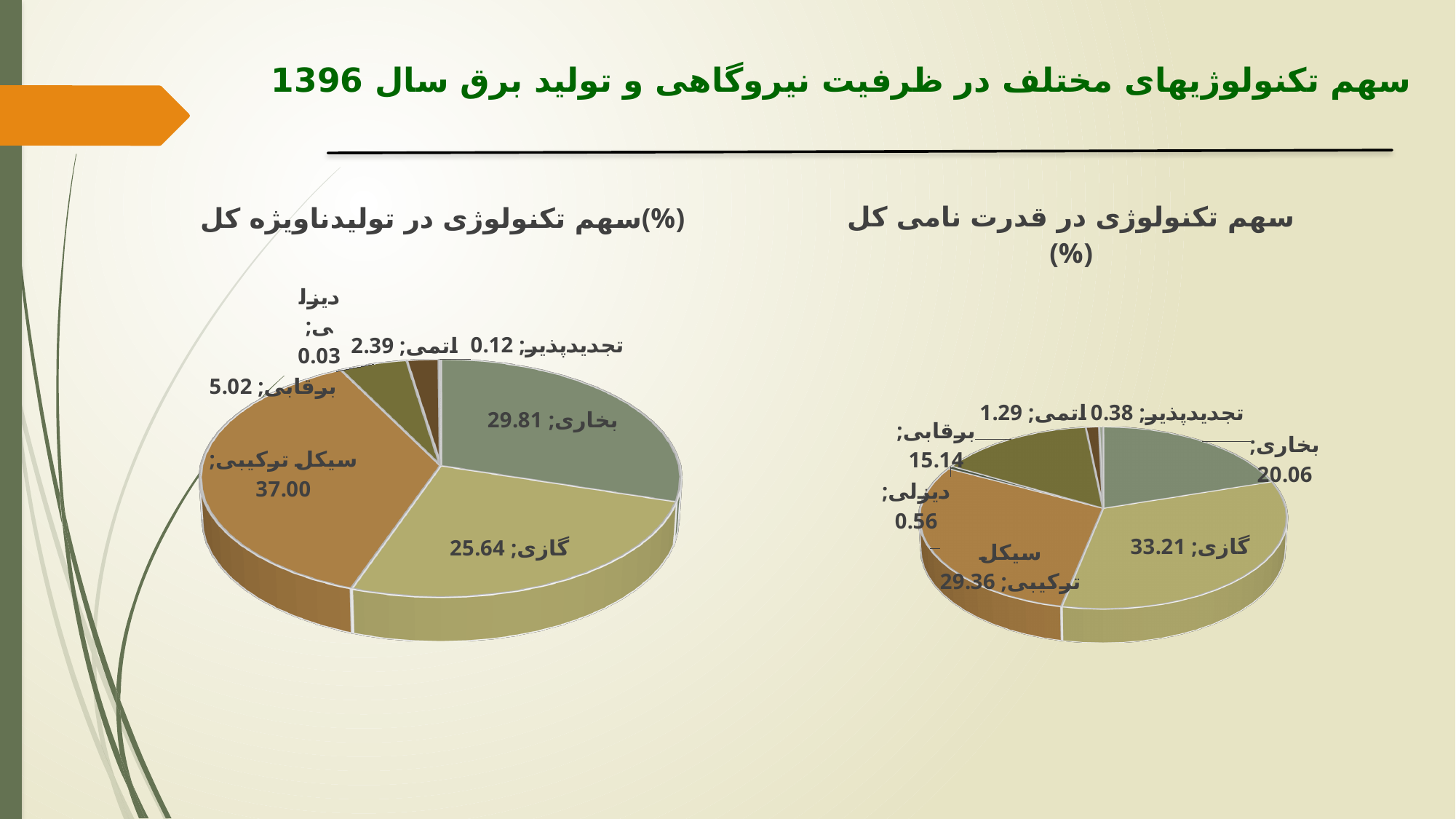
In the left chart (سهم تکنولوژی در تولیدناویژه کل), what is the value for اتمی? 2.39 In the right chart (سهم تکنولوژی در قدرت نامی کل), what is the difference between the values for گازی and بخاری? 13.15 In the right chart (سهم تکنولوژی در قدرت نامی کل), which category has the largest share? گازی What is the title of the slide? سهم تکنولوژیهای مختلف در ظرفیت نیروگاهی و تولید برق سال 1396 What type of chart is used on the slide for both charts? Pie chart In the left chart (سهم تکنولوژی در تولیدناویژه کل), what is the difference between the values for سیکل ترکیبی and گازی? 11.36 In the right chart (سهم تکنولوژی در قدرت نامی کل), what is the value for گازی? 33.21 In the right chart (سهم تکنولوژی در قدرت نامی کل), which is larger: بخاری or سیکل ترکیبی? سیکل ترکیبی In the left chart (سهم تکنولوژی در تولیدناویژه کل), what is the value for سیکل ترکیبی? 37.00 How many categories are shown in the right chart (سهم تکنولوژی در قدرت نامی کل)? 7 In the right chart (سهم تکنولوژی در قدرت نامی کل), what is the value for برقابی? 15.14 In the left chart (سهم تکنولوژی در تولیدناویژه کل), which category has the smallest share? دیزلی